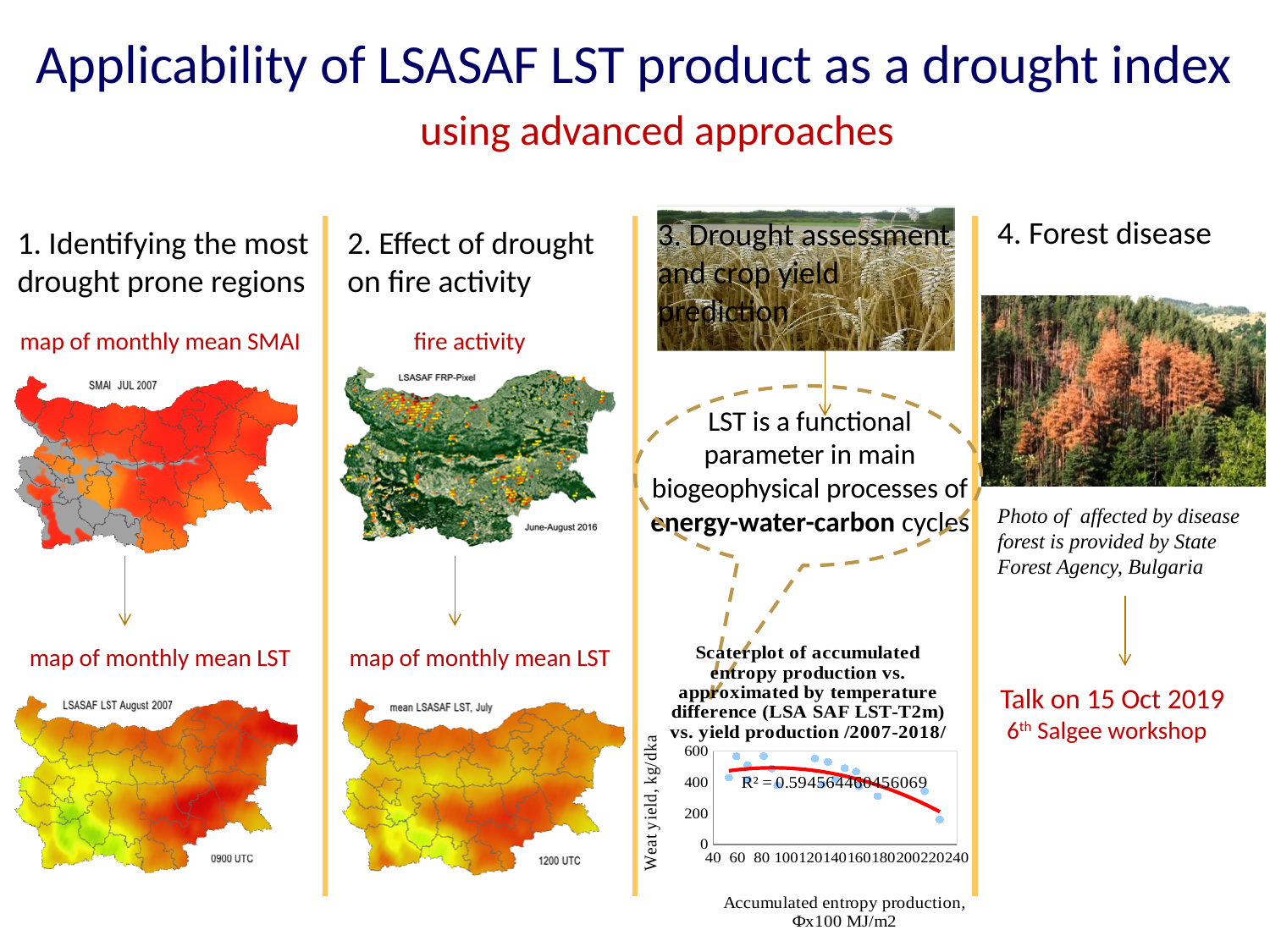
What is the highest tick value shown on the vertical axis of the scatterplot? 600 Which years does the scatterplot title say the data covers? 2007-2018 What is the label of the vertical axis of the scatterplot? Weat yield, kg/dka What kind of chart is shown at the bottom of the 'Drought assessment and crop yield prediction' column? scatter chart What is the lowest tick value shown on the horizontal axis of the scatterplot? 40 In the scatterplot, does wheat yield generally rise or fall as accumulated entropy production increases along the x axis? fall What is the highest tick value shown on the horizontal axis of the scatterplot? 240 In the scatterplot, is the wheat yield for the rightmost point (near 220 on the x axis) greater or less than 200? less What is the label of the horizontal axis of the scatterplot? Accumulated entropy production, Φx100 MJ/m2 In the scatterplot, is the wheat yield for the points near 60 on the x axis greater or less than 400? greater